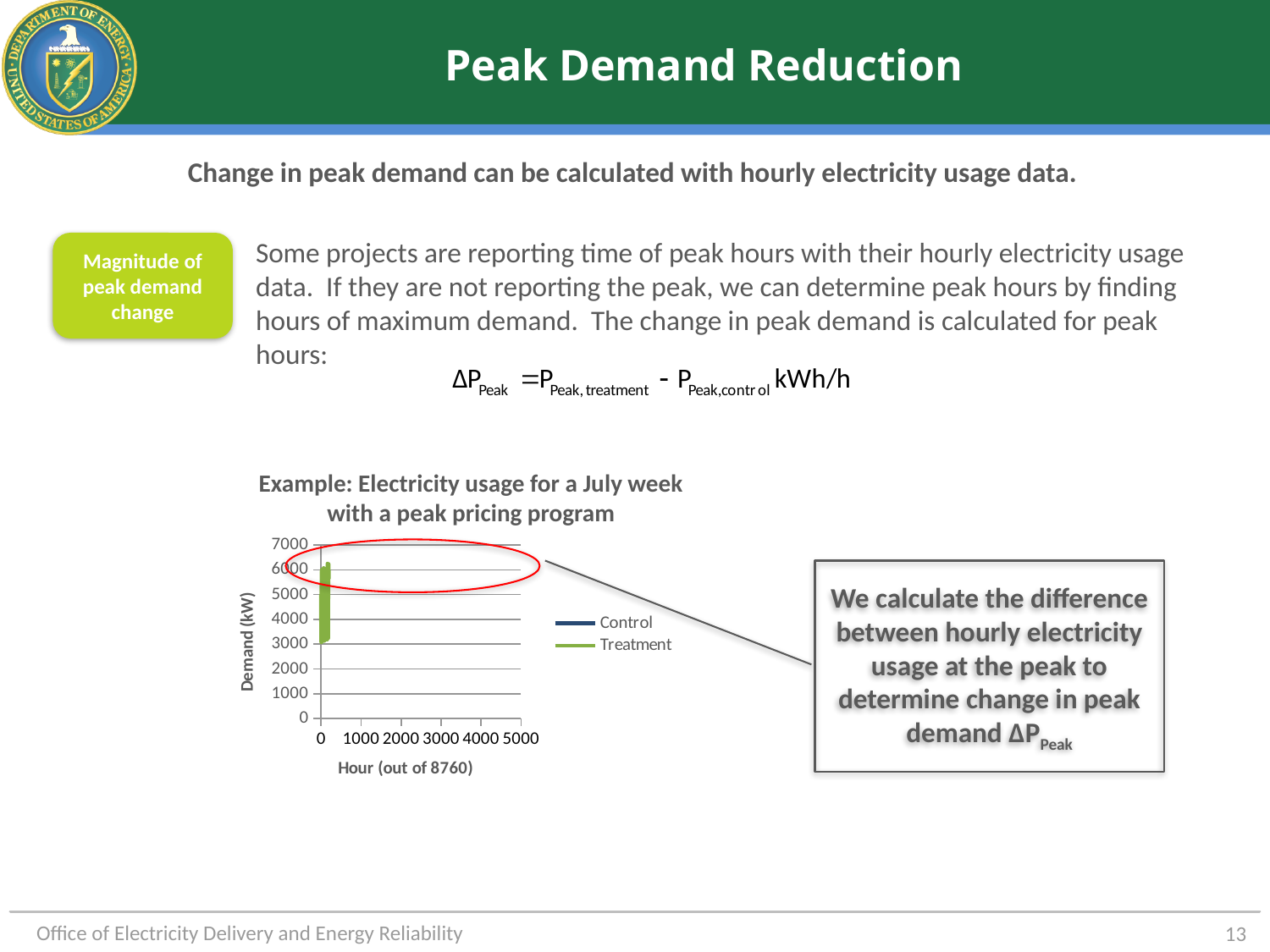
What is the title of the chart? Example: Electricity usage for a July week with a peak pricing program What kind of chart is shown on the slide? Line chart Are the plotted hours in the chart greater or less than 1000? less Is the highest plotted demand value in the chart greater or less than 5000? greater What are the two series named in the chart's legend? Control and Treatment Is the lowest plotted demand value in the chart greater or less than 2000? greater How many series does the chart's legend list? 2